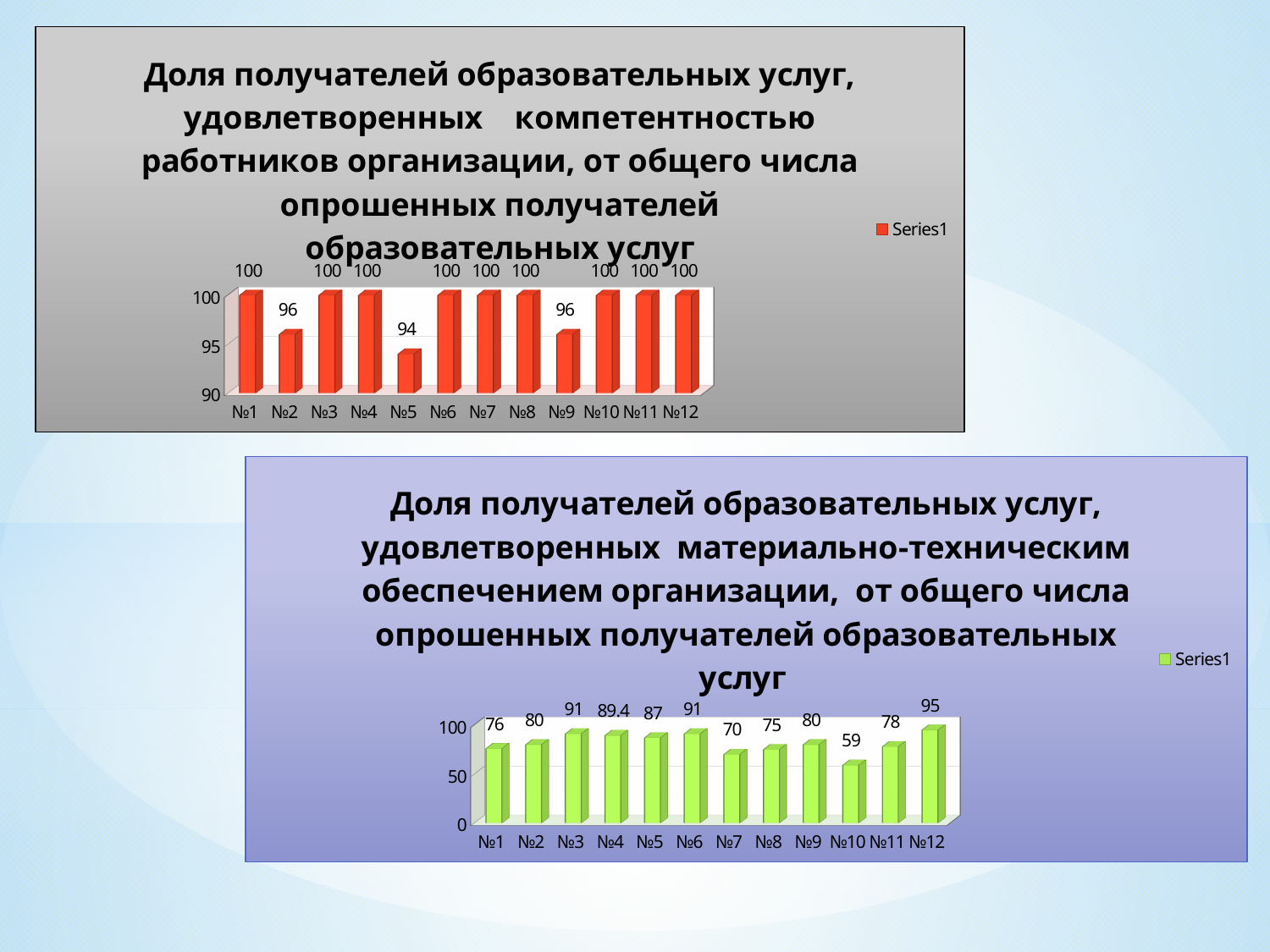
In the top chart, what is the value for №5? 94 In the bottom chart, what is the value for №4? 89.4 In the top chart, which category has the lowest value? №5 In the bottom chart, which is larger, the value for №7 or the value for №8? №8 How many categories are shown in the bottom chart? 12 In the top chart, what is the value for №9? 96 In the bottom chart, which category has the lowest value? №10 What type of chart is the top chart? Bar chart In the bottom chart, what is the difference between the values for №12 and №10? 36 In the top chart, what is the difference between the values for №1 and №2? 4 In the bottom chart, what is the value for №10? 59 In the bottom chart, which category has the highest value? №12